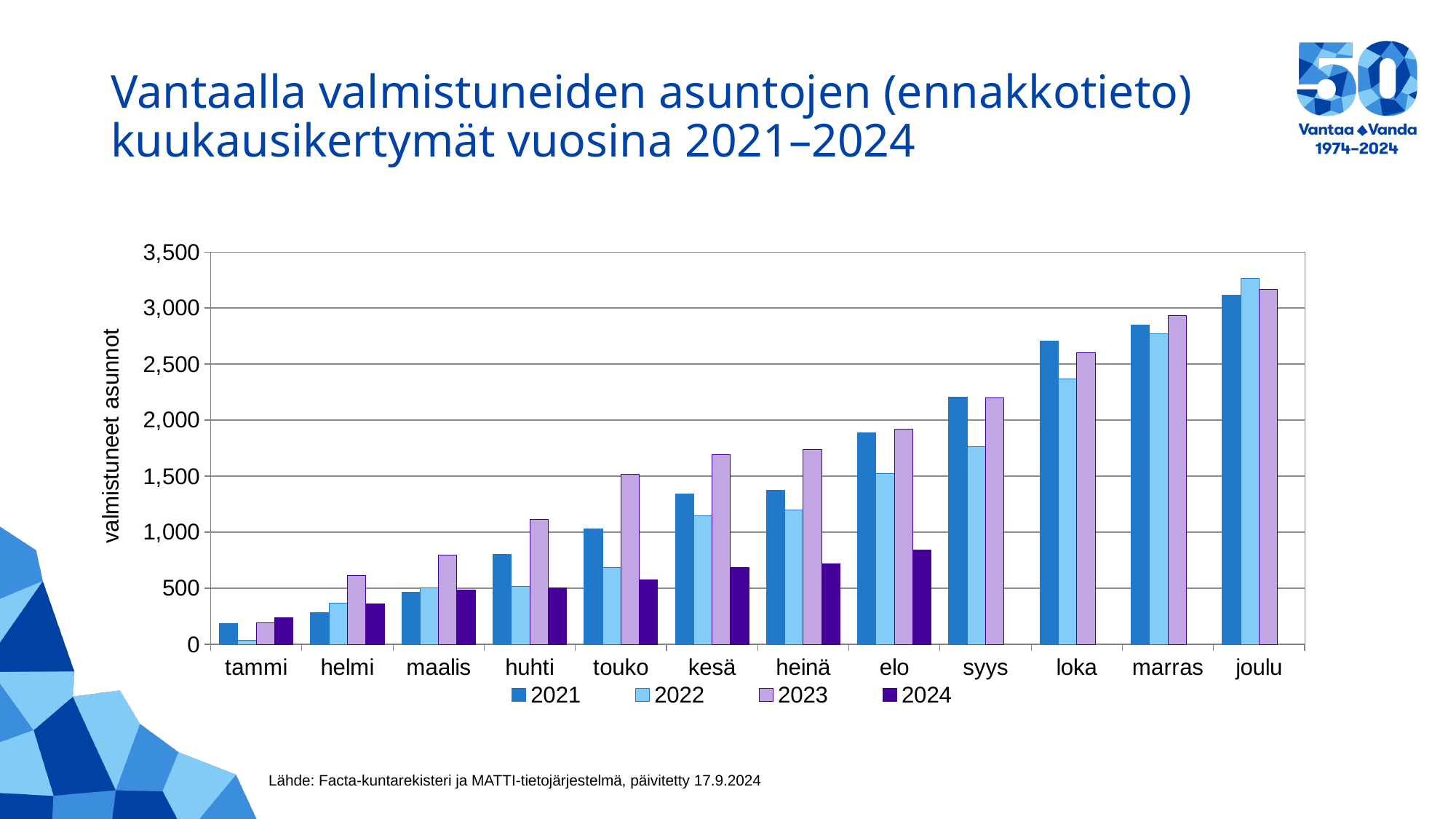
Is the value for 2022 in joulu greater or less than 3,000? greater Which month has the highest value for the 2023 series? joulu Is the value for 2022 in touko greater or less than 500? greater Do the values for the 2021 series rise or fall from tammi to joulu? rise How many months are shown on the x axis? 12 How many months have a bar for 2024? 8 Which month has the lowest value for the 2022 series? tammi In loka, which series has the larger value, 2021 or 2022? 2021 What kind of chart is shown on the slide? bar chart Is the value for 2023 in huhti greater or less than 1,000? greater How many series does the legend list? 4